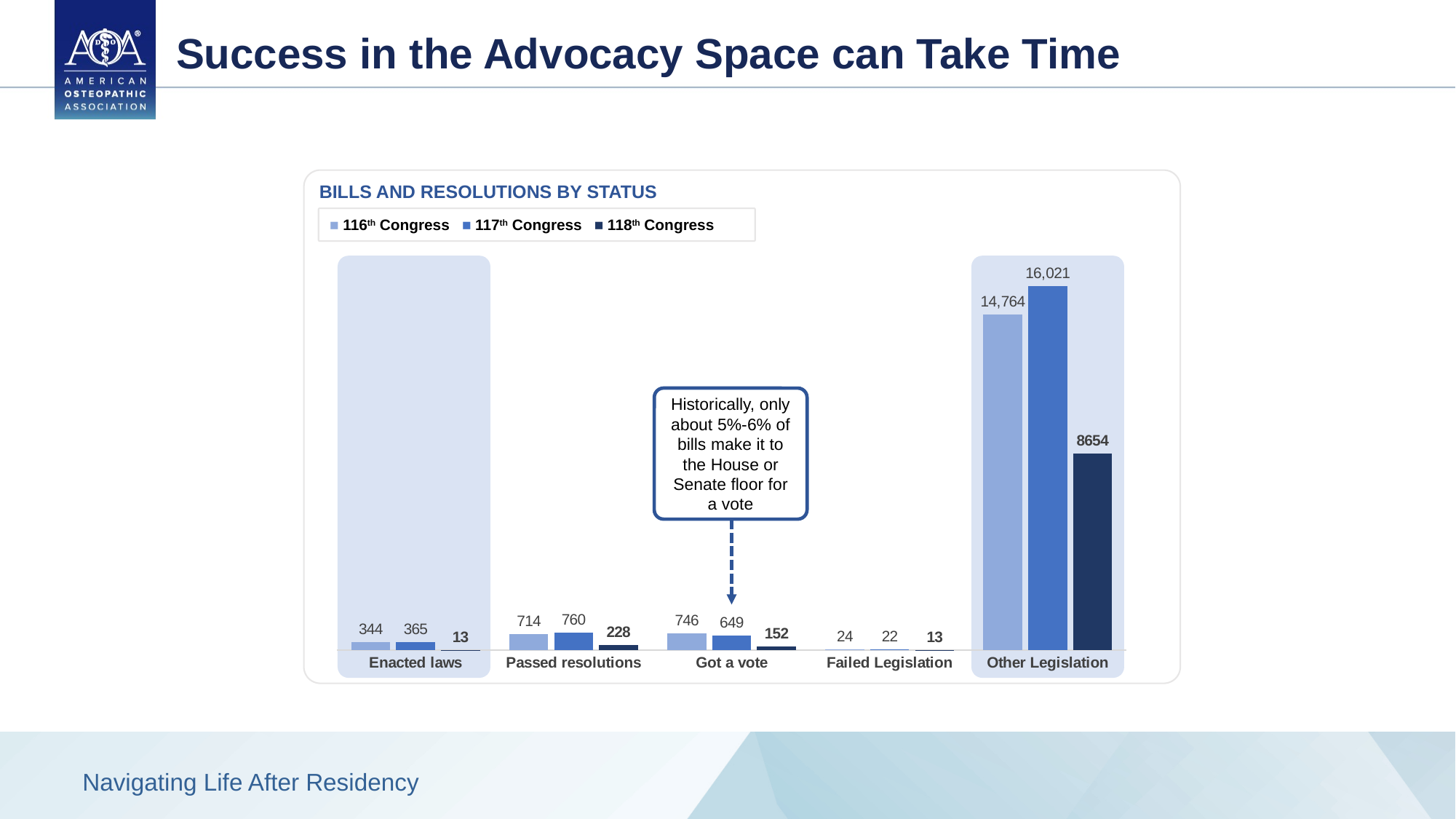
Which is larger for Passed resolutions: the 116th Congress value or the 117th Congress value? 117th Congress How many categories are shown on the x axis? 5 What is the value for the 117th Congress in the Other Legislation category? 16,021 What is the difference between the 116th Congress and 118th Congress values for Passed resolutions? 486 What is the difference between the 117th Congress and 116th Congress values for Other Legislation? 1,257 What type of chart is shown on the slide? bar chart Which category has the lowest value for the 117th Congress? Failed Legislation What is the title of the chart? BILLS AND RESOLUTIONS BY STATUS Which category has the highest value for the 116th Congress? Other Legislation How many series does the legend list? 3 What is the value for the 118th Congress in the Enacted laws category? 13 What is the value for the 116th Congress in the Got a vote category? 746